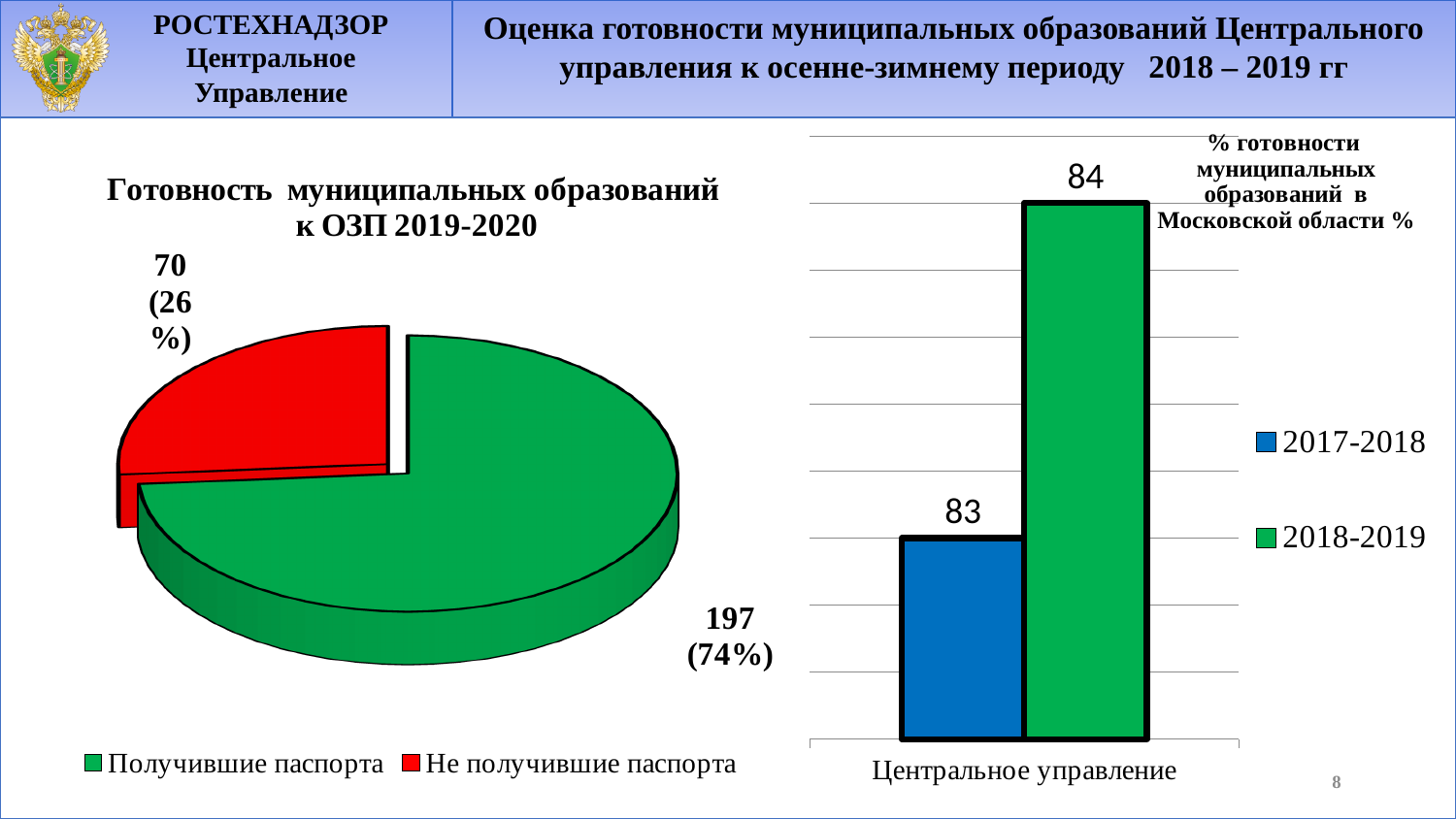
In the pie chart on the left, how many municipalities received passports (Получившие паспорта)? 197 In the pie chart on the left, how many municipalities did not receive passports (Не получившие паспорта)? 70 In the bar chart on the right, what is the difference between the 2018-2019 and 2017-2018 values? 1 In the pie chart on the left, what is the total of the two slices? 267 In the pie chart on the left, what share of the pie is the slice for Получившие паспорта? 74% In the bar chart on the right, what is the value for 2018-2019 for Центральное управление? 84 In the pie chart on the left, what share of the pie is the slice for Не получившие паспорта? 26% In the pie chart on the left, which slice is larger: Получившие паспорта or Не получившие паспорта? Получившие паспорта What kind of chart is the chart on the left of the slide? Pie chart What kind of chart is the chart on the right of the slide? Bar chart How many series does the legend of the bar chart on the right list? 2 In the bar chart on the right, what is the value for 2017-2018 for Центральное управление? 83